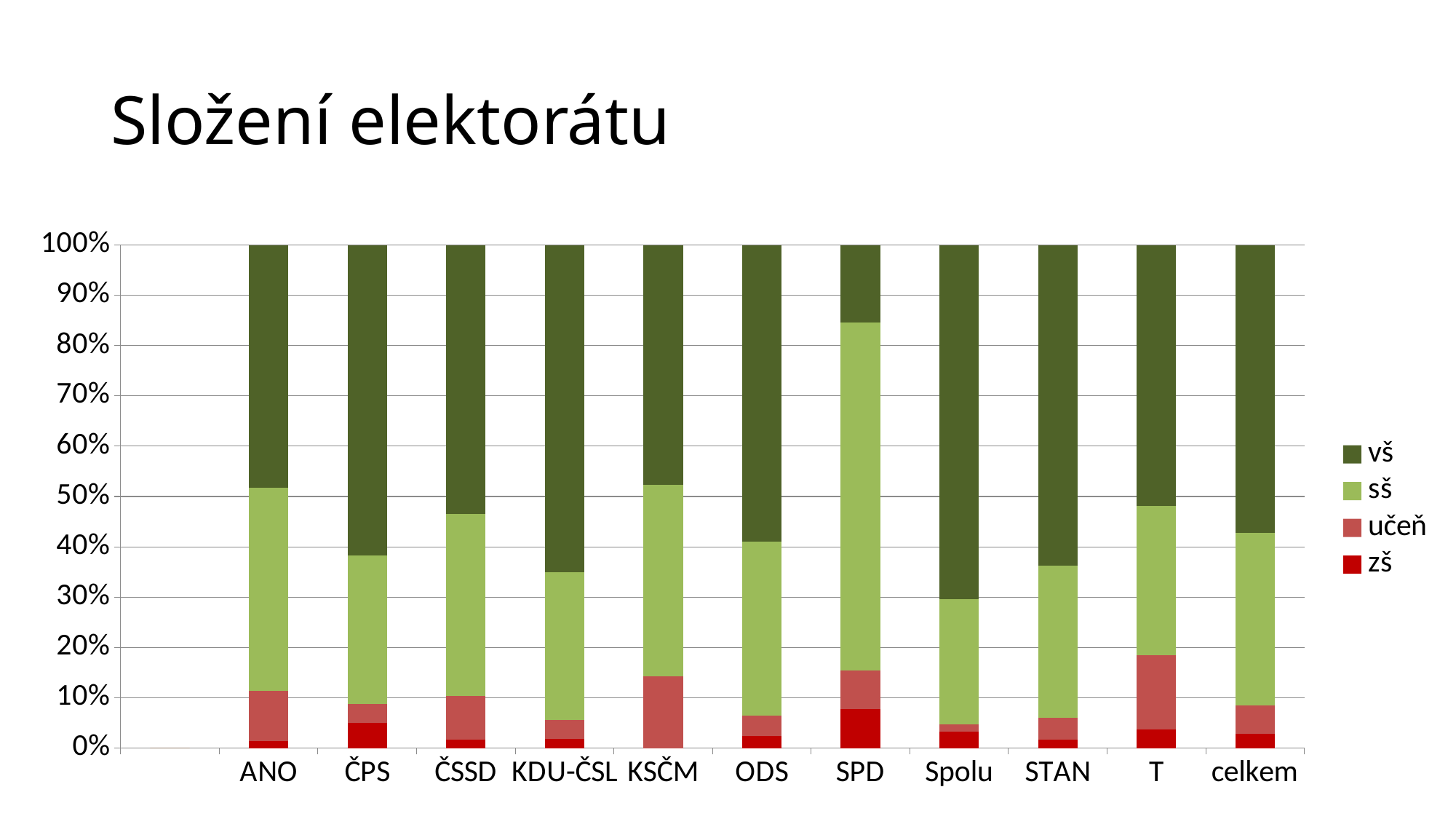
What is the title of the chart? Složení elektorátu Which category has the largest učeň segment? T Which category has the smallest vš segment? SPD Which is larger, the vš segment for Spolu or the vš segment for SPD? Spolu Which category has the largest sš segment? SPD Is the sš value for SPD greater or less than 60%? greater How many categories are shown on the x axis? 11 How many series does the legend list? 4 Is the vš value for Spolu greater or less than 60%? greater Which category has the largest vš segment? Spolu What kind of chart is shown on the slide? stacked bar chart Is the učeň value for KSČM greater or less than 10%? greater